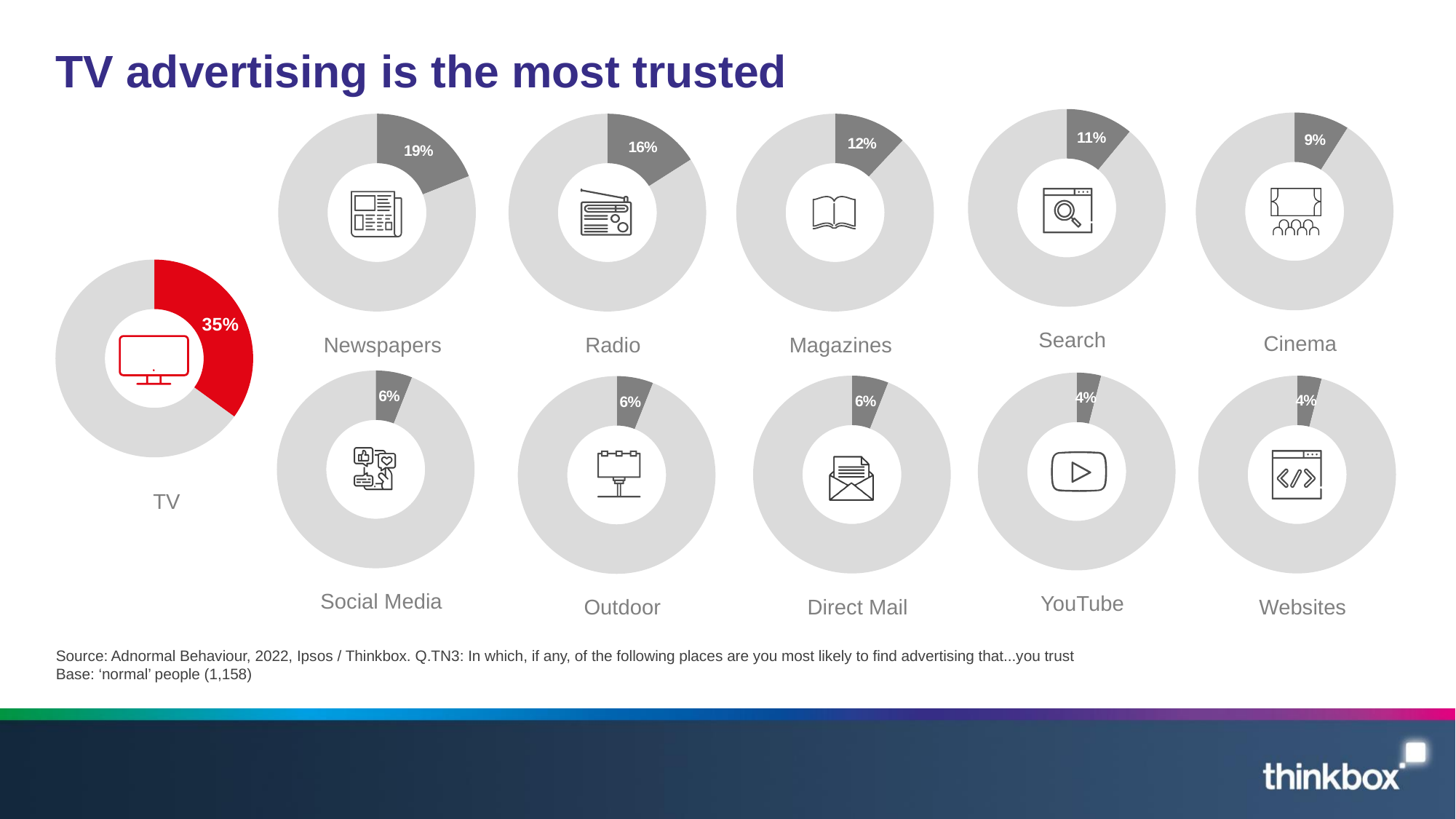
How many media categories are shown on the slide? 11 What kind of chart is used for each medium on the slide? Donut chart What is the difference between the Magazines percentage and the Search percentage? 1% What percentage is shown for TV? 35% Which has a larger percentage, Radio or Magazines? Radio What percentage is shown for Newspapers? 19% What percentage is shown for Cinema? 9% Which medium has the highest percentage on the slide? TV What percentage is shown for YouTube? 4% What percentage is shown for Radio? 16% What is the title of the slide? TV advertising is the most trusted What is the difference between the TV percentage and the Newspapers percentage? 16%